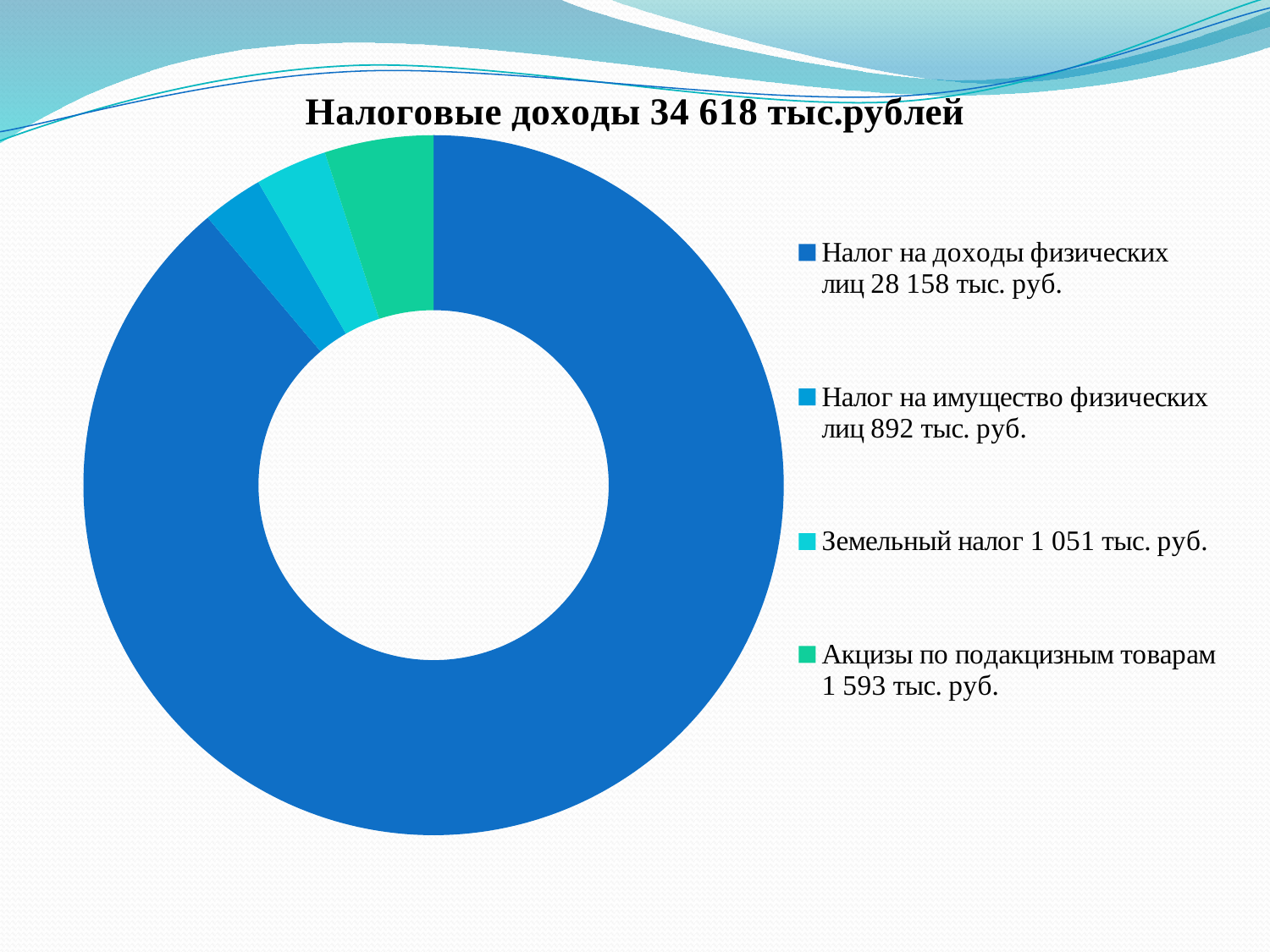
How many categories does the chart's legend list? 4 What is the difference between Земельный налог and Налог на имущество физических лиц? 159 тыс. руб. What kind of chart is shown on the slide? Doughnut (pie) chart Which category has the largest slice of the chart? Налог на доходы физических лиц What is the difference between Акцизы по подакцизным товарам and Земельный налог? 542 тыс. руб. What is the title of the chart? Налоговые доходы 34 618 тыс.рублей Which is larger: Земельный налог or Акцизы по подакцизным товарам? Акцизы по подакцизным товарам What is the value for Налог на доходы физических лиц? 28 158 тыс. руб. Which category has the smallest slice of the chart? Налог на имущество физических лиц What is the value for Налог на имущество физических лиц? 892 тыс. руб. What is the value for Земельный налог? 1 051 тыс. руб. What is the value for Акцизы по подакцизным товарам? 1 593 тыс. руб.